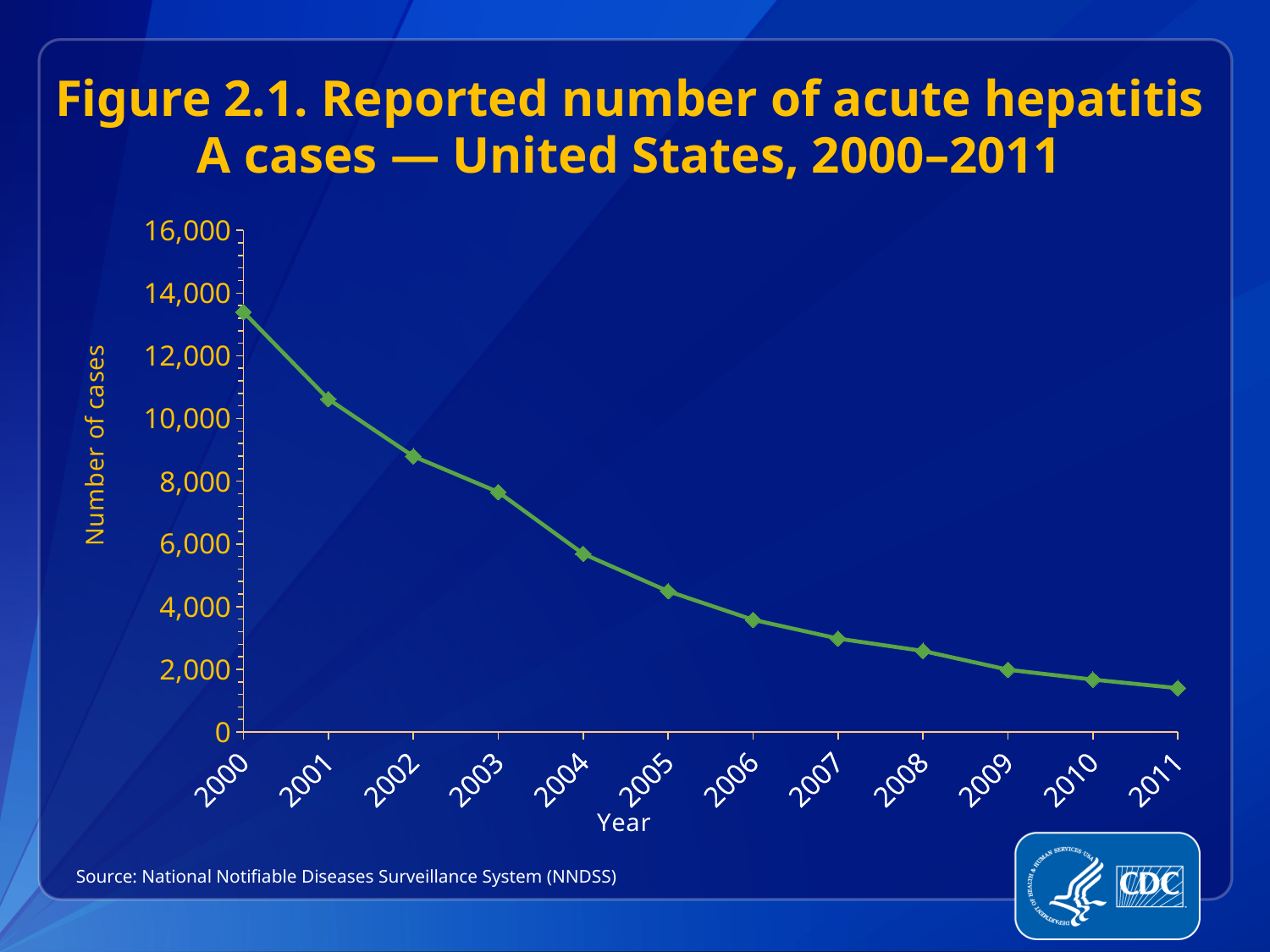
How many years (data points) are plotted on the chart? 12 Is the value for 2002 greater or less than 10,000? less Which year has the lowest reported number of acute hepatitis A cases? 2011 Is the value for 2006 greater or less than 4,000? less Is the value for 2000 greater or less than 12,000? greater Do the reported cases rise or fall from 2000 to 2011? fall What kind of chart is shown on the slide? line chart Which year has more reported cases, 2001 or 2005? 2001 Which year has the highest reported number of acute hepatitis A cases? 2000 What is the label on the vertical axis of the chart? Number of cases